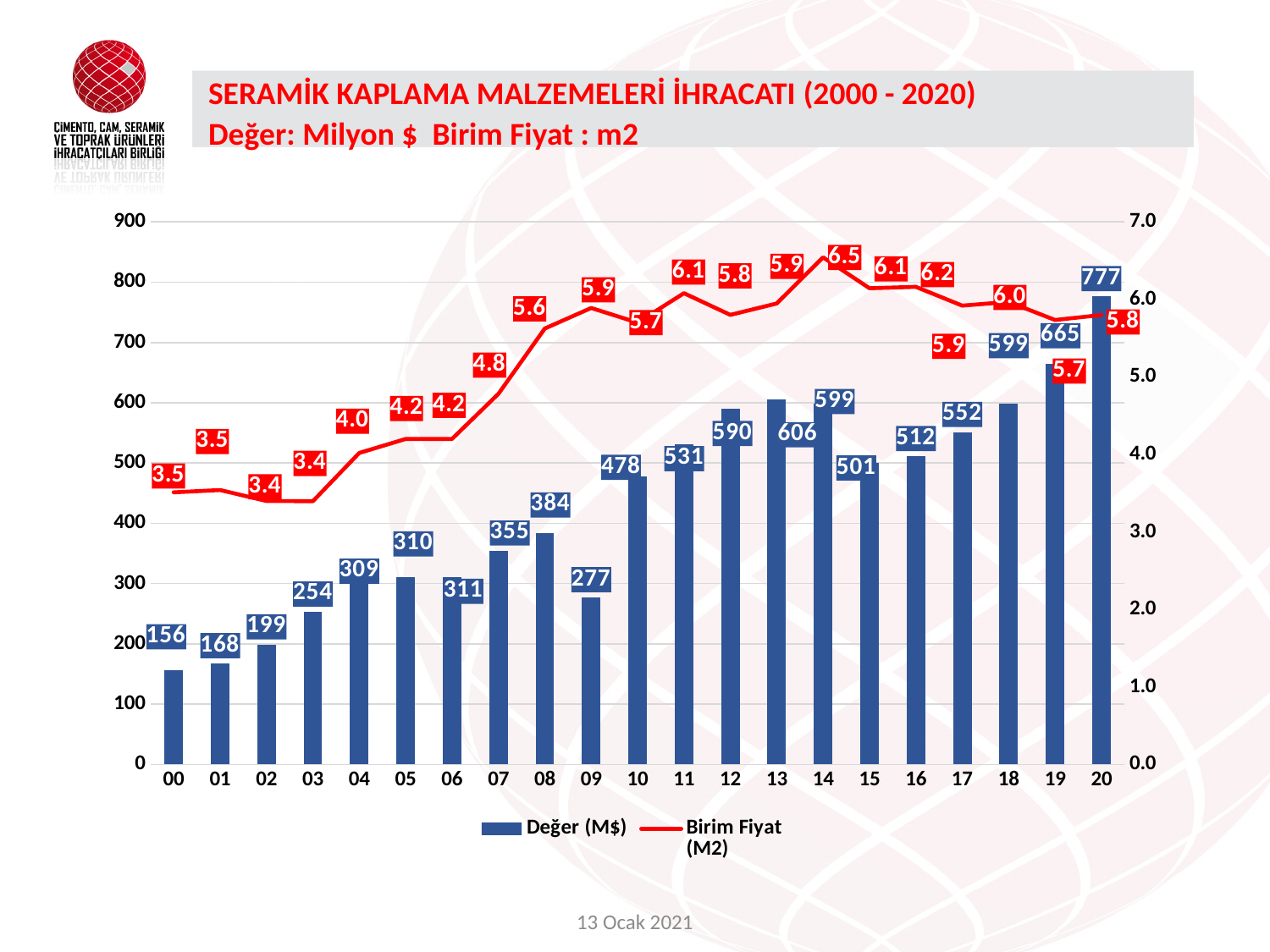
What is the difference between the Değer (M$) values for 2020 and 2019? 112 Which year has the highest Birim Fiyat (M2) value? 14 What is the Birim Fiyat (M2) value for 2014 (label "14")? 6.5 How many series does the legend list? 2 What kind of chart is shown on the slide? Combined bar and line chart Which year has the lowest Değer (M$) value? 00 How many years are shown on the x axis? 21 Which is larger, the Değer (M$) value for 2013 or for 2014? 2013 What is the title of the chart? SERAMİK KAPLAMA MALZEMELERİ İHRACATI (2000 - 2020) What is the Değer (M$) value for 2009 (label "09")? 277 What is the Değer (M$) value for 2020 (label "20")? 777 Which year has the highest Değer (M$) value? 20